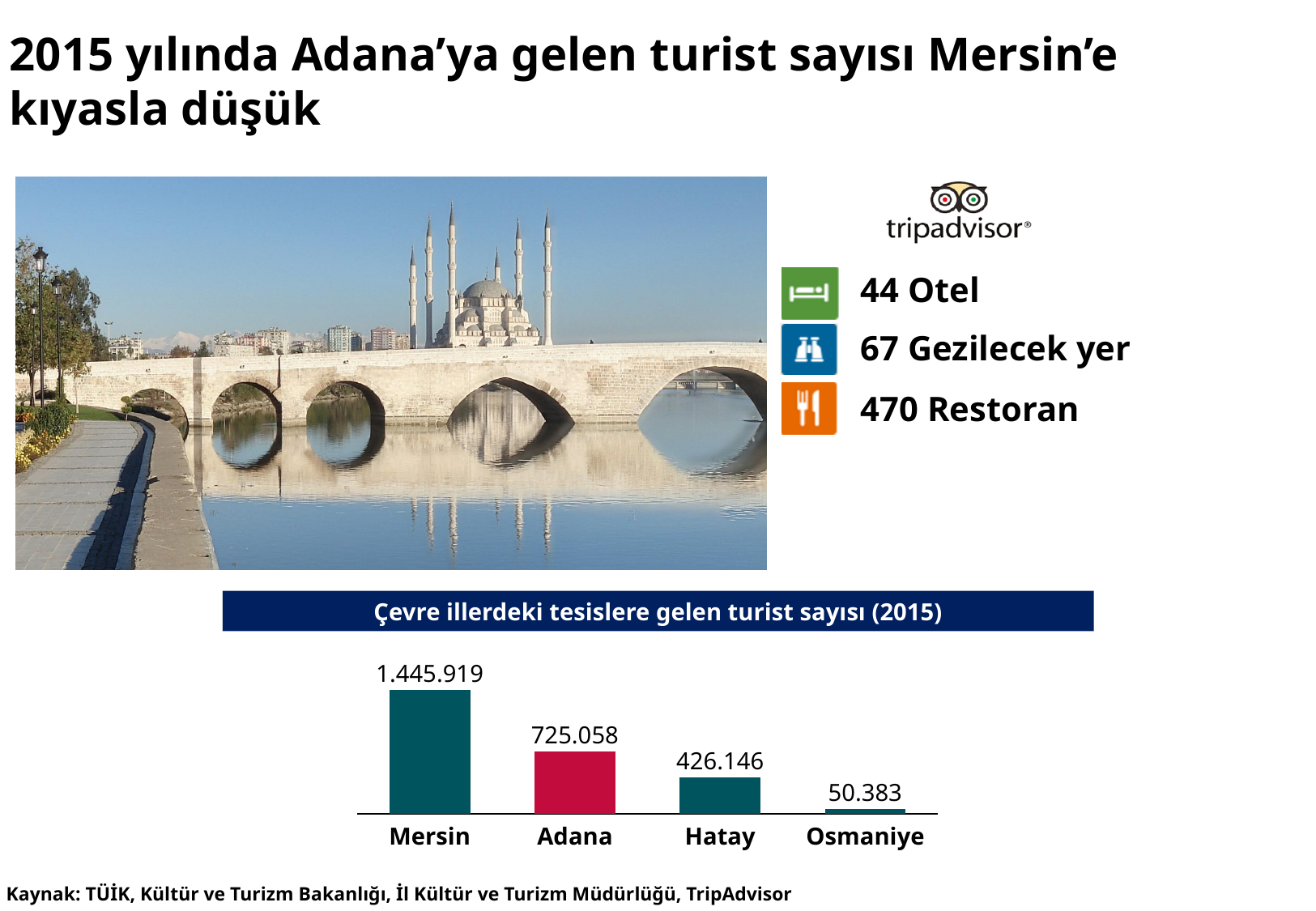
How many provinces are shown in the chart? 4 Which bar in the chart is coloured differently (red) from the others? Adana What is the number of tourists shown for Mersin? 1.445.919 What type of chart is shown on the slide? Bar chart What is the number of tourists shown for Hatay? 426.146 What is the number of tourists shown for Adana? 725.058 Which province has the highest number of tourists in the chart? Mersin Which province has the lowest number of tourists in the chart? Osmaniye What is the number of tourists shown for Osmaniye? 50.383 What is the title of the chart on the slide? Çevre illerdeki tesislere gelen turist sayısı (2015) Which has more tourists, Adana or Hatay? Adana What is the difference between the tourist numbers for Mersin and Adana? 720.861